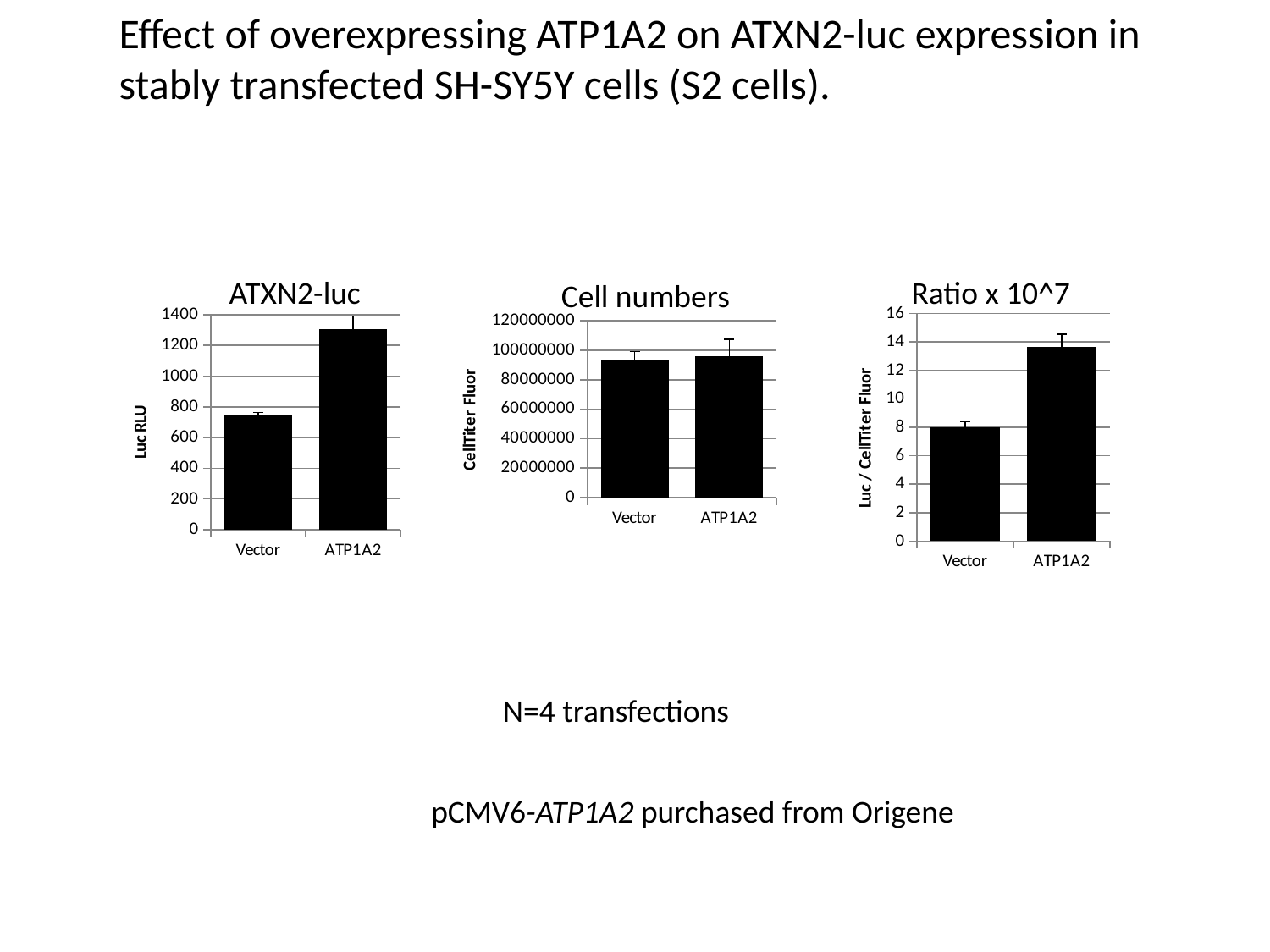
In the Ratio x 10^7 chart, is the value for Vector greater or less than 10? less In the Cell numbers chart, is the value for Vector greater or less than 80000000? greater In the Cell numbers chart, is the value for ATP1A2 greater or less than 100000000? less What is the y-axis title of the Ratio x 10^7 chart? Luc / CellTiter Fluor How many categories are shown on the x axis of the ATXN2-luc chart? 2 In the Ratio x 10^7 chart, which category has the lower bar? Vector In the ATXN2-luc chart, which category has the higher bar? ATP1A2 What kind of chart is the Cell numbers chart? bar chart What is the y-axis title of the ATXN2-luc chart? Luc RLU